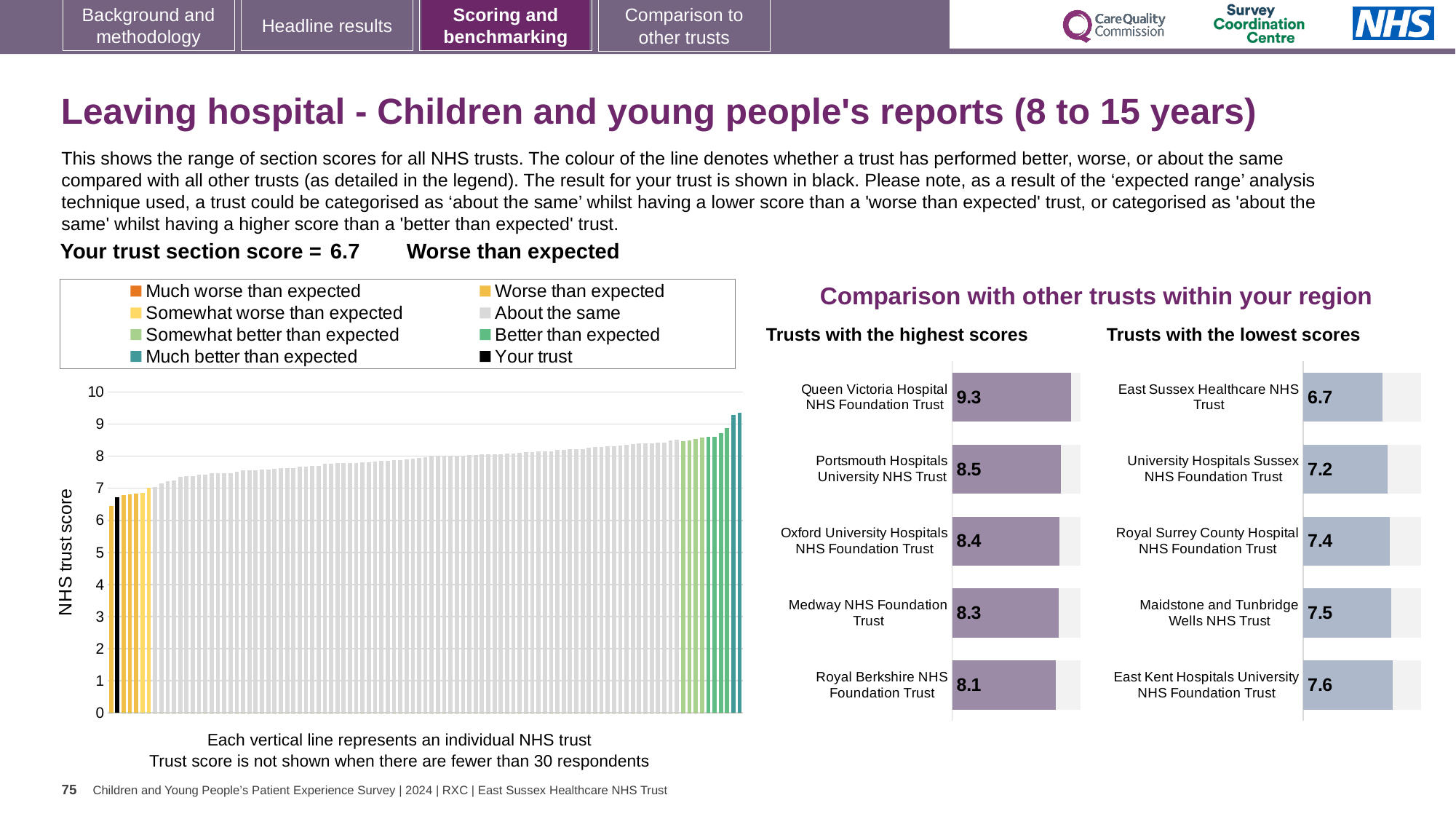
In the 'Trusts with the highest scores' chart, which trust has the lowest score? Royal Berkshire NHS Foundation Trust How many trusts are shown in the 'Trusts with the lowest scores' chart? 5 How many entries does the legend of the NHS trust score chart on the left list? 8 In the 'Trusts with the lowest scores' chart, which trust has the highest score? East Kent Hospitals University NHS Foundation Trust What kind of chart is the NHS trust score chart on the left of the slide? Bar chart In the NHS trust score chart on the left, what colour represents 'Your trust' in the legend? Black In the 'Trusts with the highest scores' chart, what is the difference between the scores of Queen Victoria Hospital NHS Foundation Trust and Royal Berkshire NHS Foundation Trust? 1.2 In the 'Trusts with the lowest scores' chart, what is the difference between the scores of East Kent Hospitals University NHS Foundation Trust and East Sussex Healthcare NHS Trust? 0.9 In the 'Trusts with the highest scores' chart, which has the larger score: Portsmouth Hospitals University NHS Trust or Medway NHS Foundation Trust? Portsmouth Hospitals University NHS Trust In the 'Trusts with the lowest scores' chart, what is the score for Royal Surrey County Hospital NHS Foundation Trust? 7.4 In the 'Trusts with the highest scores' chart, what is the score for Queen Victoria Hospital NHS Foundation Trust? 9.3 In the NHS trust score chart on the left, do the values rise or fall from left to right? Rise